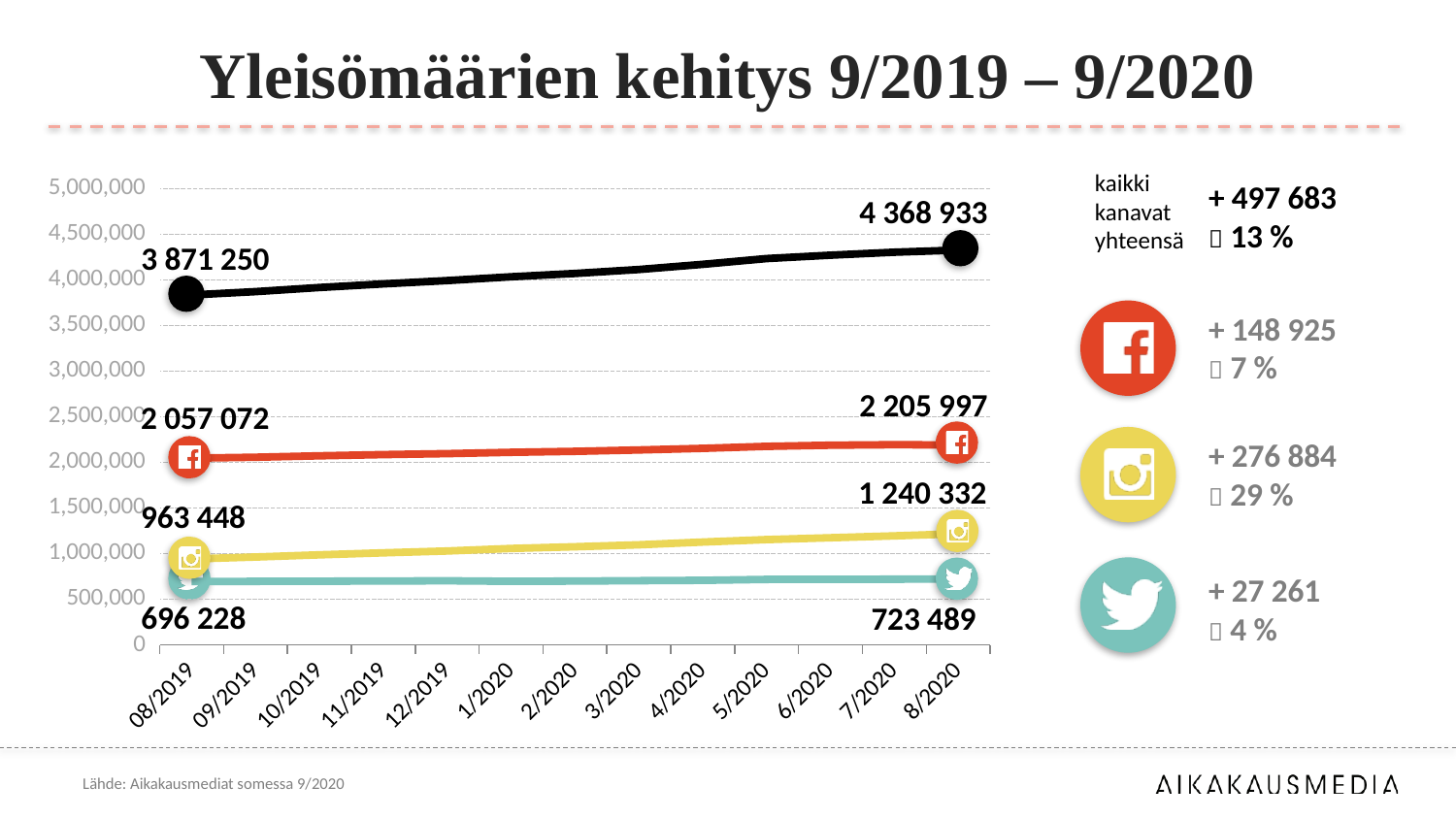
Does the Instagram line rise or fall from 08/2019 to 8/2020? rise What is the value of the black (total) line at 8/2020? 4 368 933 What is the Instagram value at 08/2019? 963 448 By how much did the Twitter line increase from 08/2019 to 8/2020? 27 261 By how much did the Instagram line increase from 08/2019 to 8/2020? 276 884 What is the Twitter value at 8/2020? 723 489 What type of chart is shown on the slide? line chart How many time points are shown on the x axis? 13 Which line has the lowest value at 8/2020? Twitter (696 228 → 723 489 line) Which is larger at 08/2019: the Facebook value or the Instagram value? Facebook What is the value of the black (total) line at 08/2019? 3 871 250 What is the Facebook value at 8/2020? 2 205 997